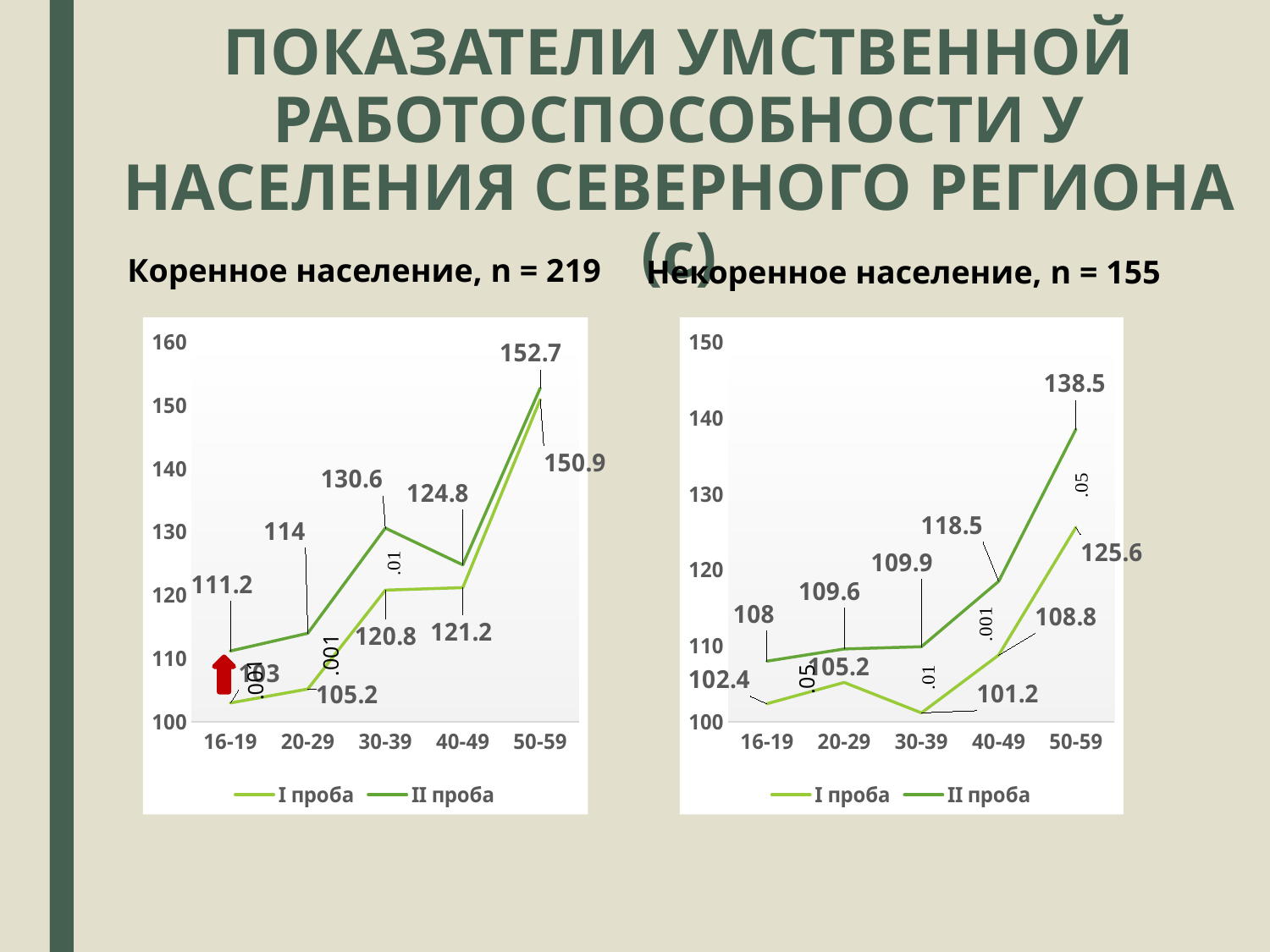
How many age groups are shown on the x axis of the chart titled 'Некоренное население, n = 155'? 5 In the chart titled 'Некоренное население, n = 155', how much higher is II проба for 50-59 than for 40-49? 20 In the chart titled 'Коренное население, n = 219', what is the difference between II проба and I проба for the 50-59 age group? 1.8 In the chart titled 'Коренное население, n = 219', is II проба larger for the 30-39 or the 40-49 age group? 30-39 In the chart titled 'Коренное население, n = 219', is the value of I проба for the 20-29 age group greater or less than 110? less What kind of chart is the chart titled 'Коренное население, n = 219'? line chart In the chart titled 'Некоренное население, n = 155', which age group has the lowest value for I проба? 30-39 In the chart titled 'Коренное население, n = 219', what is the value of II проба for the 50-59 age group? 152.7 In the chart titled 'Некоренное население, n = 155', what is the value of I проба for the 16-19 age group? 102.4 In the chart titled 'Некоренное население, n = 155', what is the value of II проба for the 40-49 age group? 118.5 In the chart titled 'Коренное население, n = 219', which age group has the highest value for II проба? 50-59 In the chart titled 'Коренное население, n = 219', what is the value of I проба for the 30-39 age group? 120.8